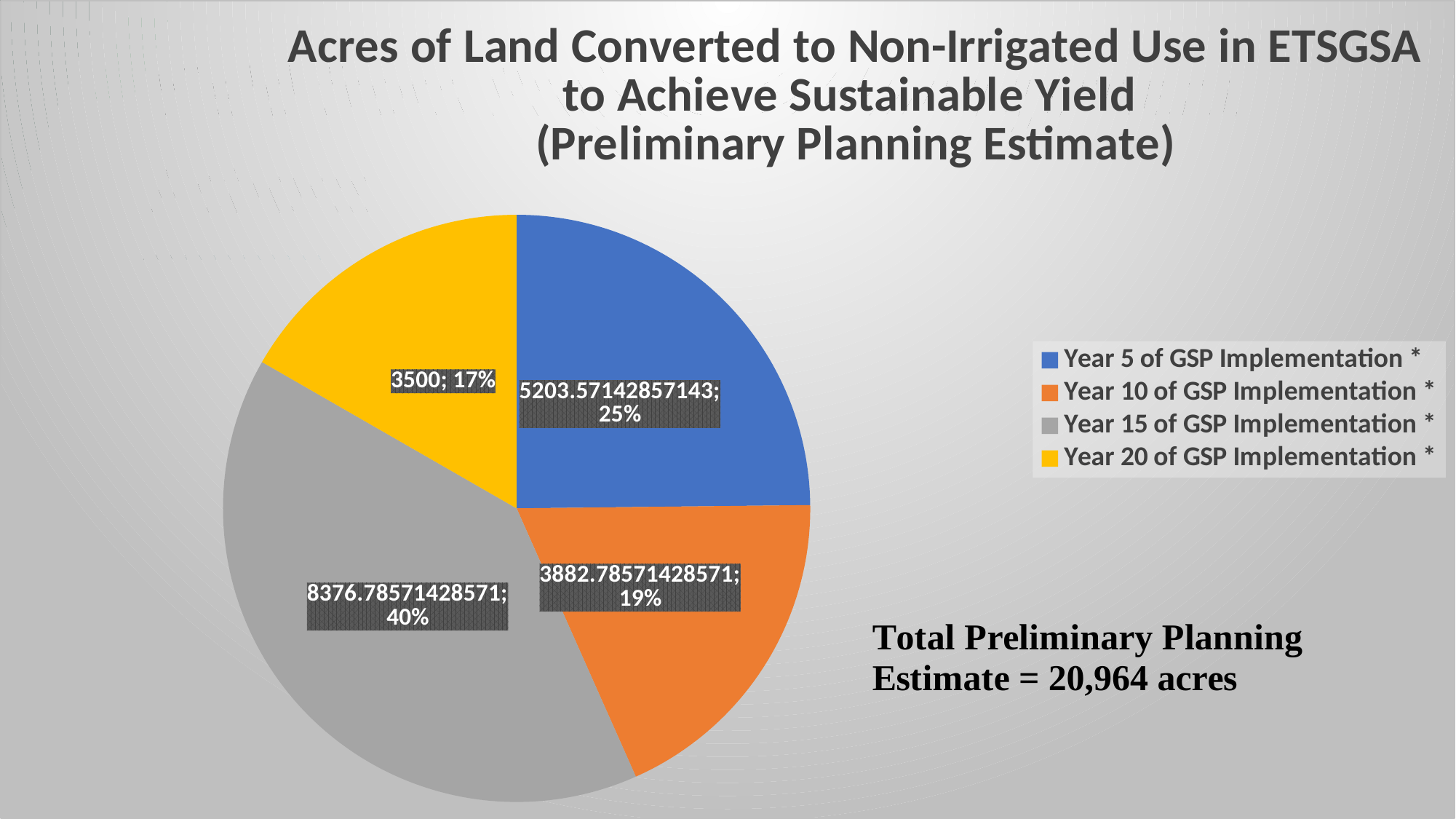
What percentage share of the pie does Year 15 of GSP Implementation have? 40% What type of chart is shown on the slide? Pie chart How many entries does the legend list? 4 What value is shown for Year 15 of GSP Implementation? 8376.78571428571 What percentage share of the pie does Year 10 of GSP Implementation have? 19% What colour is the slice for Year 10 of GSP Implementation? Orange What value is shown for Year 20 of GSP Implementation? 3500 What value is shown for Year 5 of GSP Implementation? 5203.57142857143 How many slices does the pie chart have? 4 Which is larger, the value for Year 5 of GSP Implementation or Year 10 of GSP Implementation? Year 5 of GSP Implementation Which category has the largest slice of the pie? Year 15 of GSP Implementation Which category has the smallest slice of the pie? Year 20 of GSP Implementation